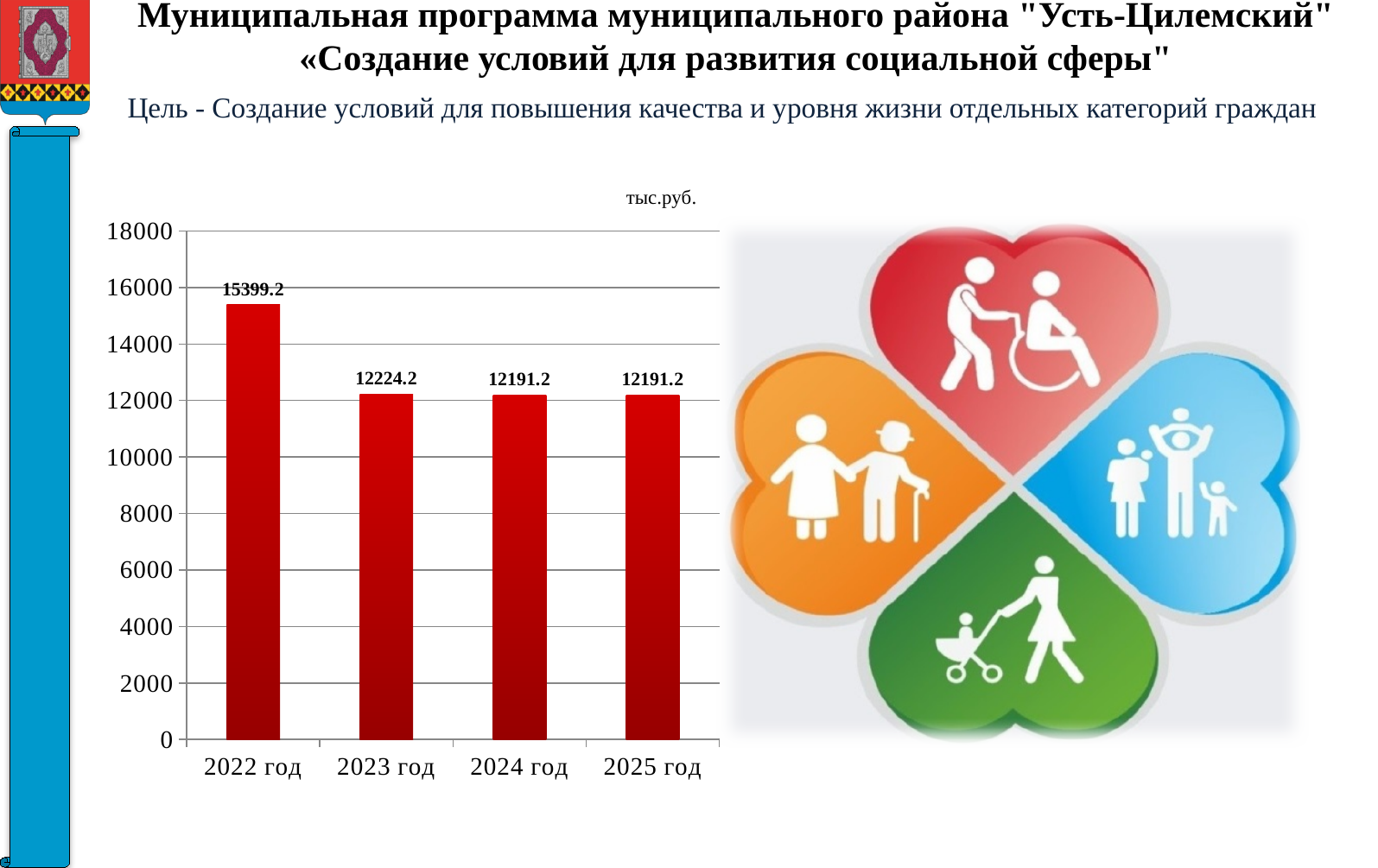
Is the value for 2023 год greater or less than 14000? less What is the value for 2022 год? 15399.2 What is the value for 2023 год? 12224.2 What kind of chart is shown on the slide? bar chart Do the values rise or fall from 2022 год to 2025 год? fall What is the difference between the values for 2022 год and 2023 год? 3175 What is the difference between the values for 2023 год and 2024 год? 33 Which is larger, the value for 2022 год or the value for 2024 год? 2022 год How many years are shown on the x axis? 4 Which year has the highest value? 2022 год What unit is shown above the chart? тыс.руб. What is the value for 2025 год? 12191.2